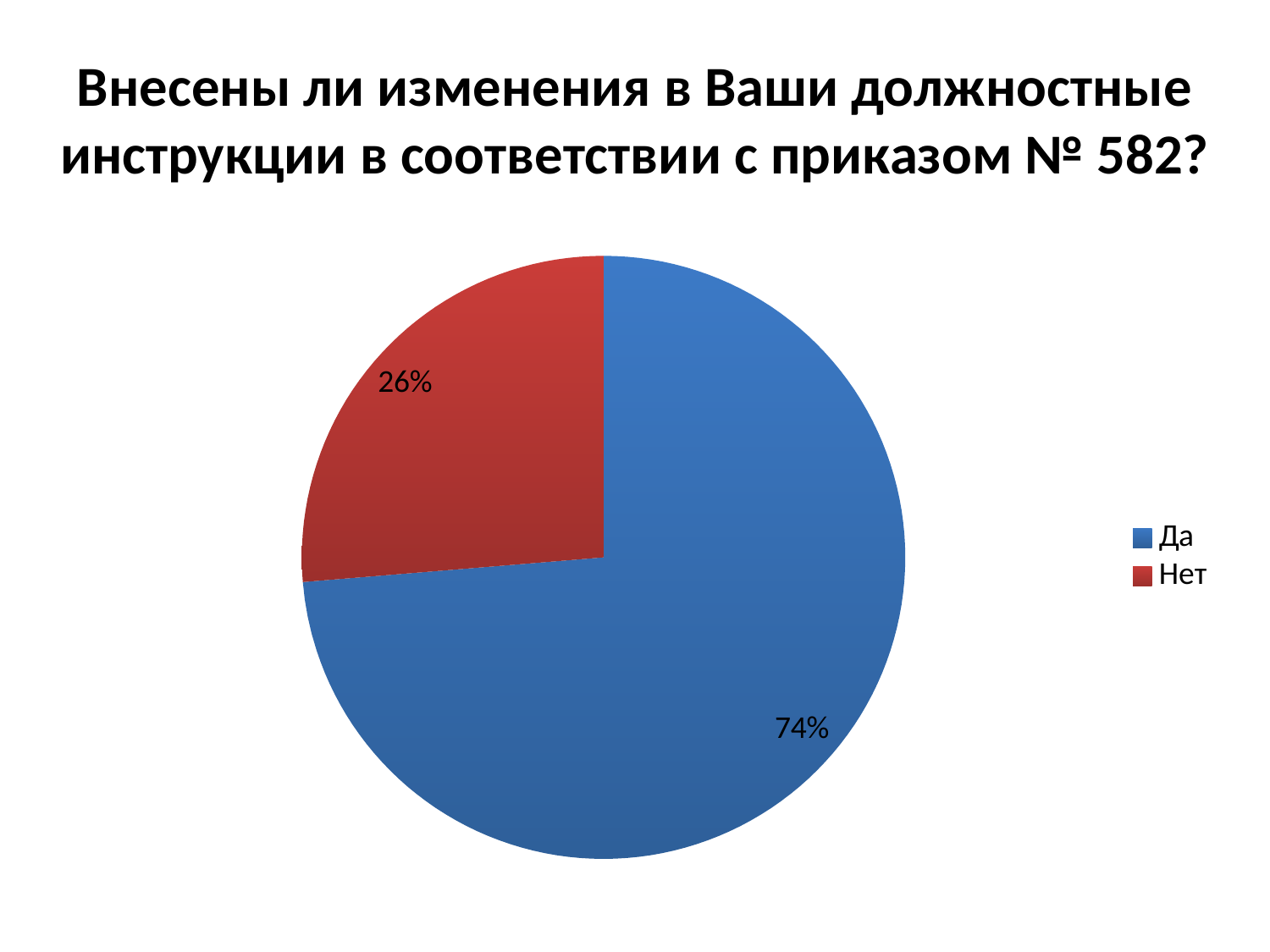
What share of the pie does the "Нет" slice represent? 26% Which category has the largest slice of the pie? Да What kind of chart is shown on the slide? Pie chart Which category has the smallest slice of the pie? Нет How many slices does the pie chart have? 2 What is the title of the chart? Внесены ли изменения в Ваши должностные инструкции в соответствии с приказом № 582? What is the difference in percentage points between the "Да" and "Нет" slices? 48 What colour is the "Нет" slice? Red How many entries does the legend list? 2 Which slice is larger, "Да" or "Нет"? Да What share of the pie does the "Да" slice represent? 74%